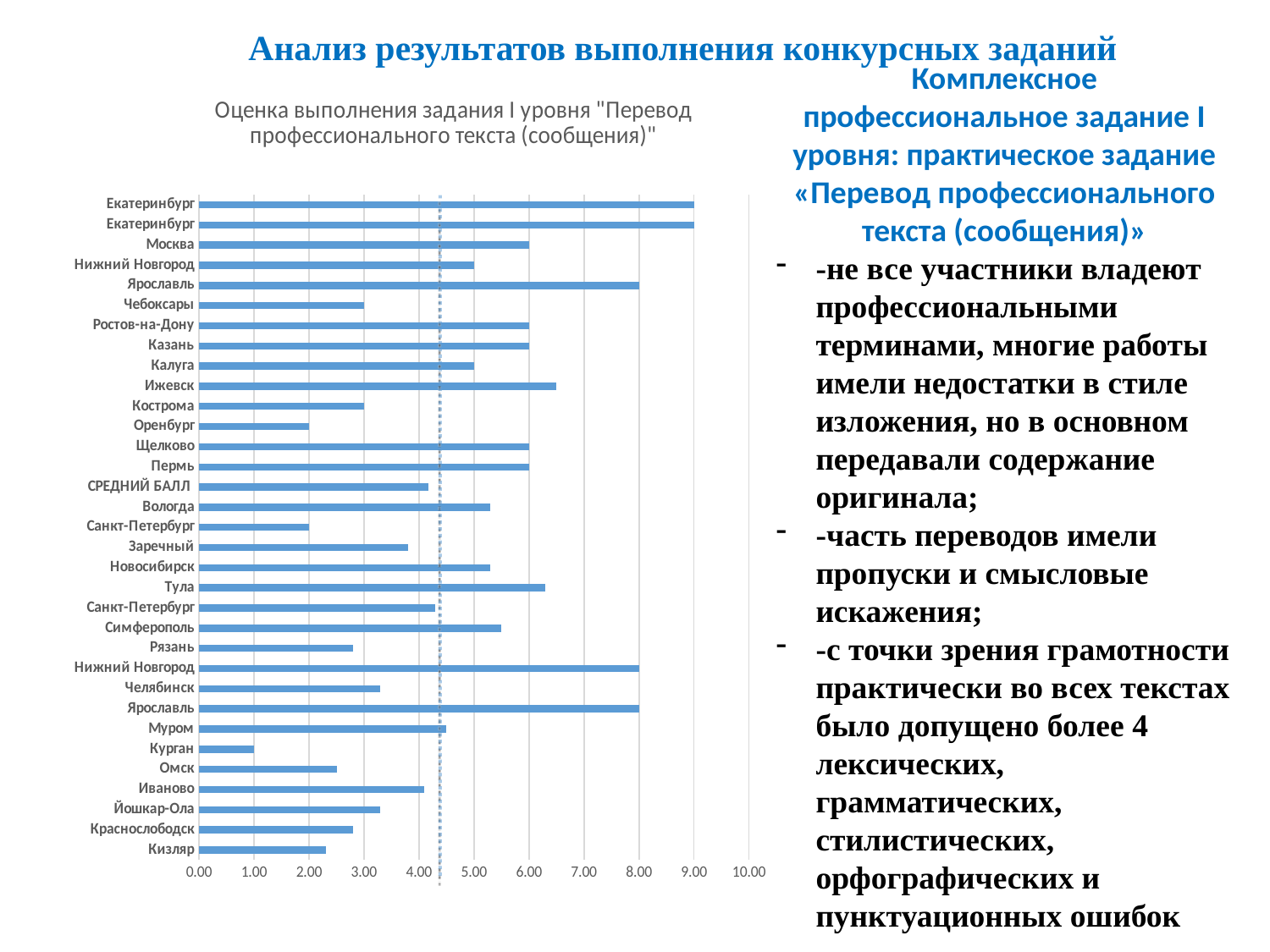
What is the value for Курган? 1.00 What is the difference between the values for Москва and Чебоксары? 3.00 Which category has the lowest value? Курган What kind of chart is shown on the slide? bar chart What is the value for Калуга? 5.00 What is the value for Москва? 6.00 What is the value for Оренбург? 2.00 Which category has the highest value? Екатеринбург What is the title of the chart? Оценка выполнения задания I уровня "Перевод профессионального текста (сообщения)" Is the value for Ижевск greater or less than 6.00? greater Which is larger, the value for Казань or the value for Кострома? Казань Is the value for Рязань greater or less than 3.00? less